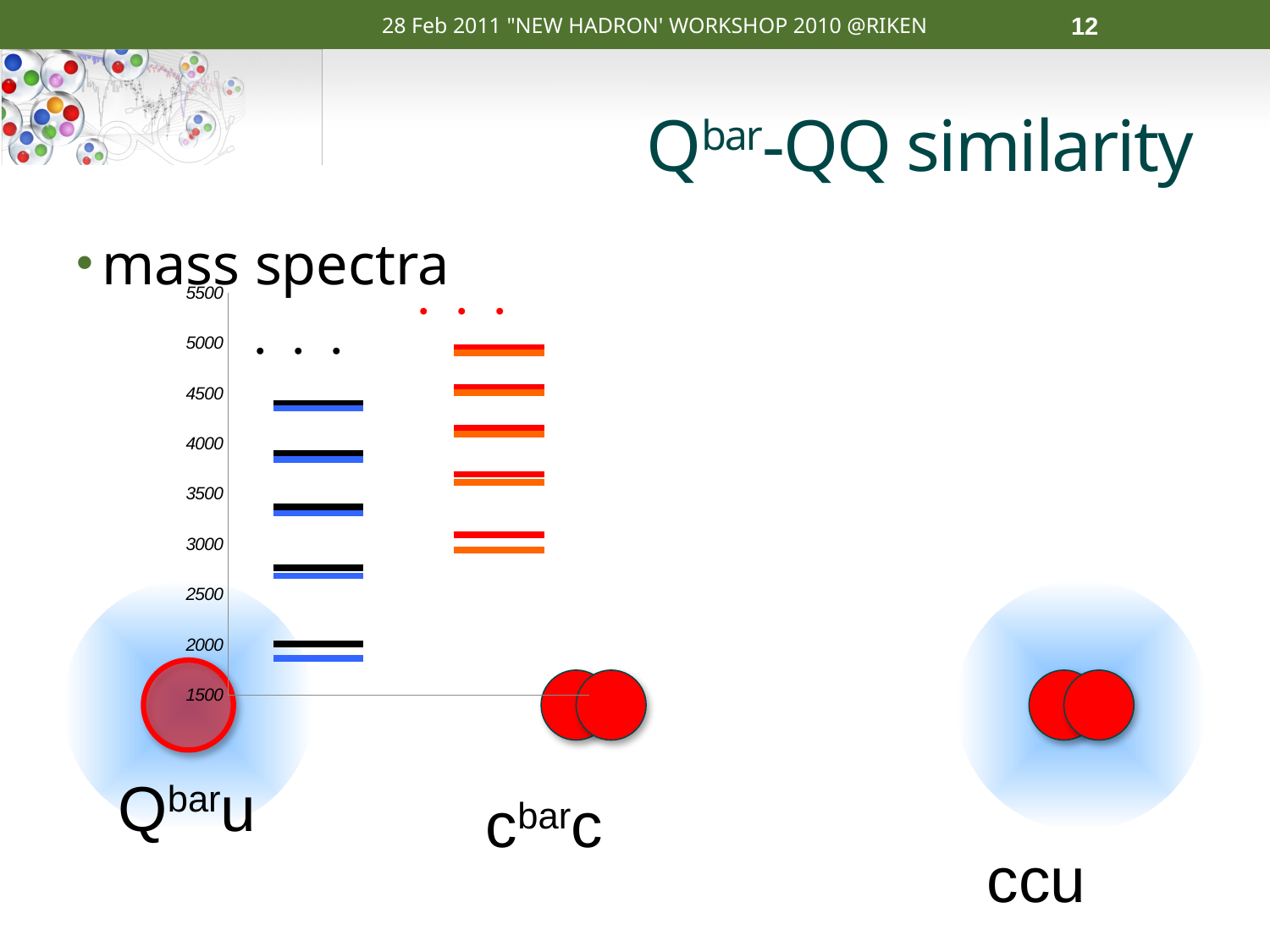
How many labelled tick marks are on the vertical axis of the mass spectra chart? 9 How many pairs of level lines are drawn in the Q̄u column of the mass spectra chart (excluding the dots)? 5 Is the highest level line in the Q̄u column of the mass spectra chart greater or less than 5000? less What is the lowest value shown on the vertical axis of the mass spectra chart? 1500 How many pairs of level lines are drawn in the c̄c column of the mass spectra chart (excluding the dots)? 5 Which column in the mass spectra chart has its highest drawn level line at a higher mass, Q̄u or c̄c? c̄c Is the lowest level in the c̄c column of the mass spectra chart greater or less than 2500? greater Is the lowest level in the Q̄u column of the mass spectra chart greater or less than 2500? less What is the highest value shown on the vertical axis of the mass spectra chart? 5500 What colours are the level lines in the c̄c column of the mass spectra chart? red and orange Which column in the mass spectra chart has its lowest level at a higher mass, Q̄u or c̄c? c̄c